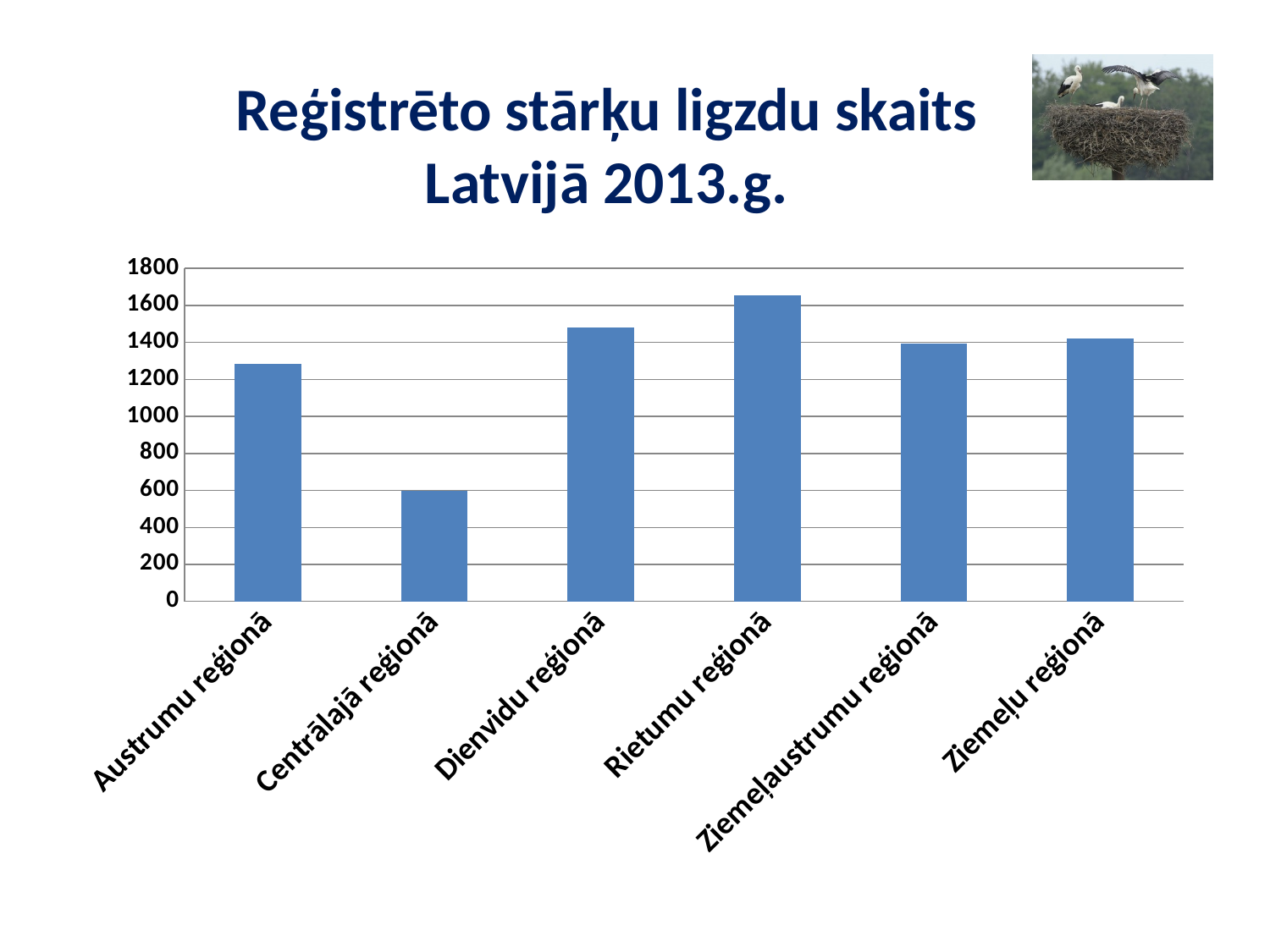
Is the value for Austrumu reģionā greater or less than 1200? greater Which has more registered stork nests, Rietumu reģionā or Dienvidu reģionā? Rietumu reģionā Is the value for Ziemeļaustrumu reģionā greater or less than 1200? greater Which region has the lowest number of registered stork nests? Centrālajā reģionā Which region has the highest number of registered stork nests? Rietumu reģionā What kind of chart is shown on the slide? Bar chart Which has more registered stork nests, Dienvidu reģionā or Austrumu reģionā? Dienvidu reģionā What is the title of the chart on the slide? Reģistrēto stārķu ligzdu skaits Latvijā 2013.g. Is the value for Rietumu reģionā greater or less than 1600? greater How many regions are shown on the x axis of the chart? 6